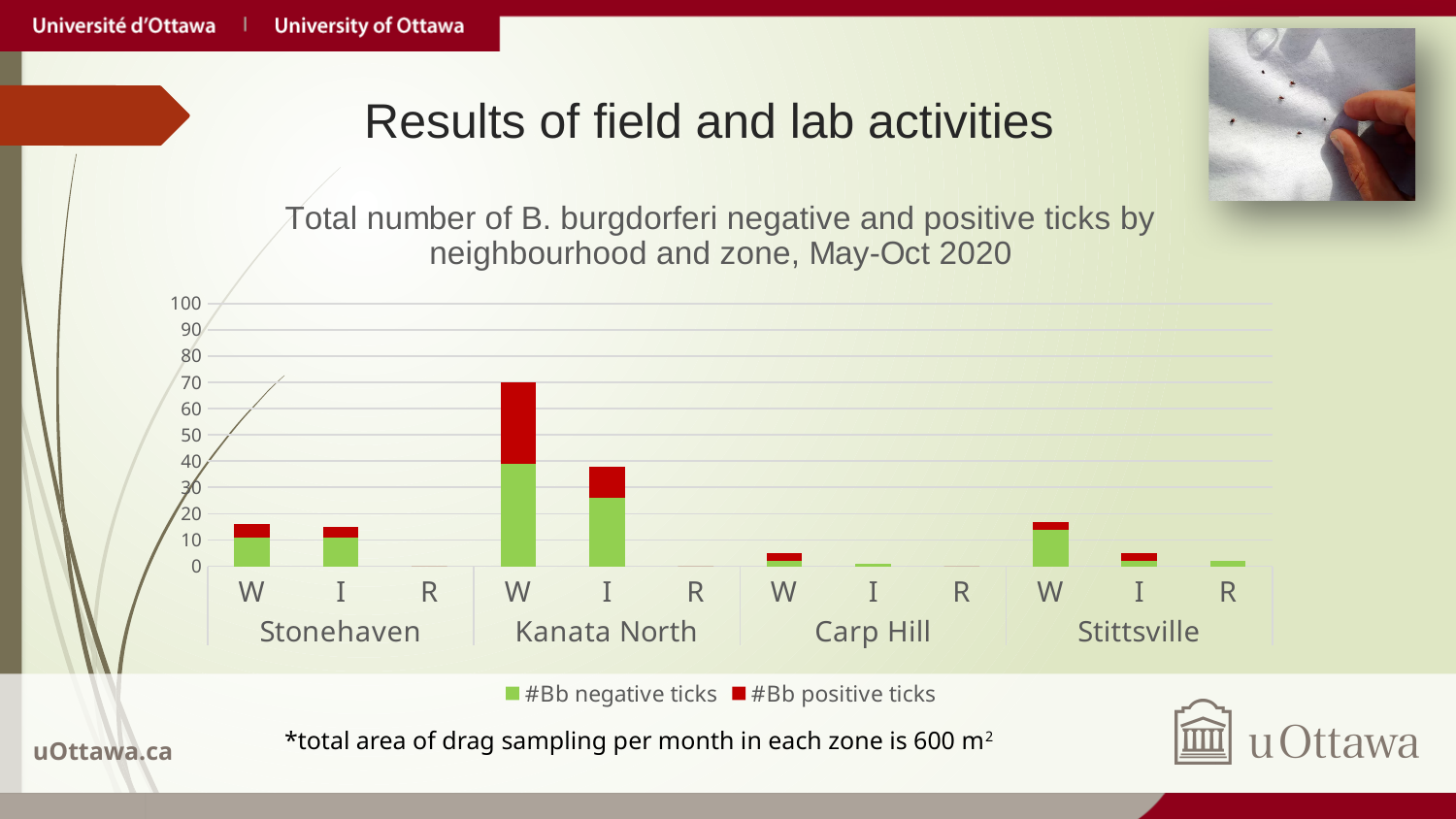
Which has a larger total number of ticks, Kanata North I or Stittsville W? Kanata North I Is the total number of ticks for Kanata North I greater or less than 50? less Is the total number of ticks for Stonehaven W greater or less than 20? less How many series does the chart legend list? 2 How many bars (zone categories) are there in total along the x axis? 12 Is the total number of ticks for Kanata North W greater or less than 60? greater What kind of chart is shown on the slide? bar chart Which has a larger total number of ticks, Kanata North W or Stonehaven W? Kanata North W Which neighbourhood and zone has the highest total number of ticks? Kanata North W How many neighbourhoods are shown along the x axis of the chart? 4 What are the two series named in the chart legend? #Bb negative ticks and #Bb positive ticks